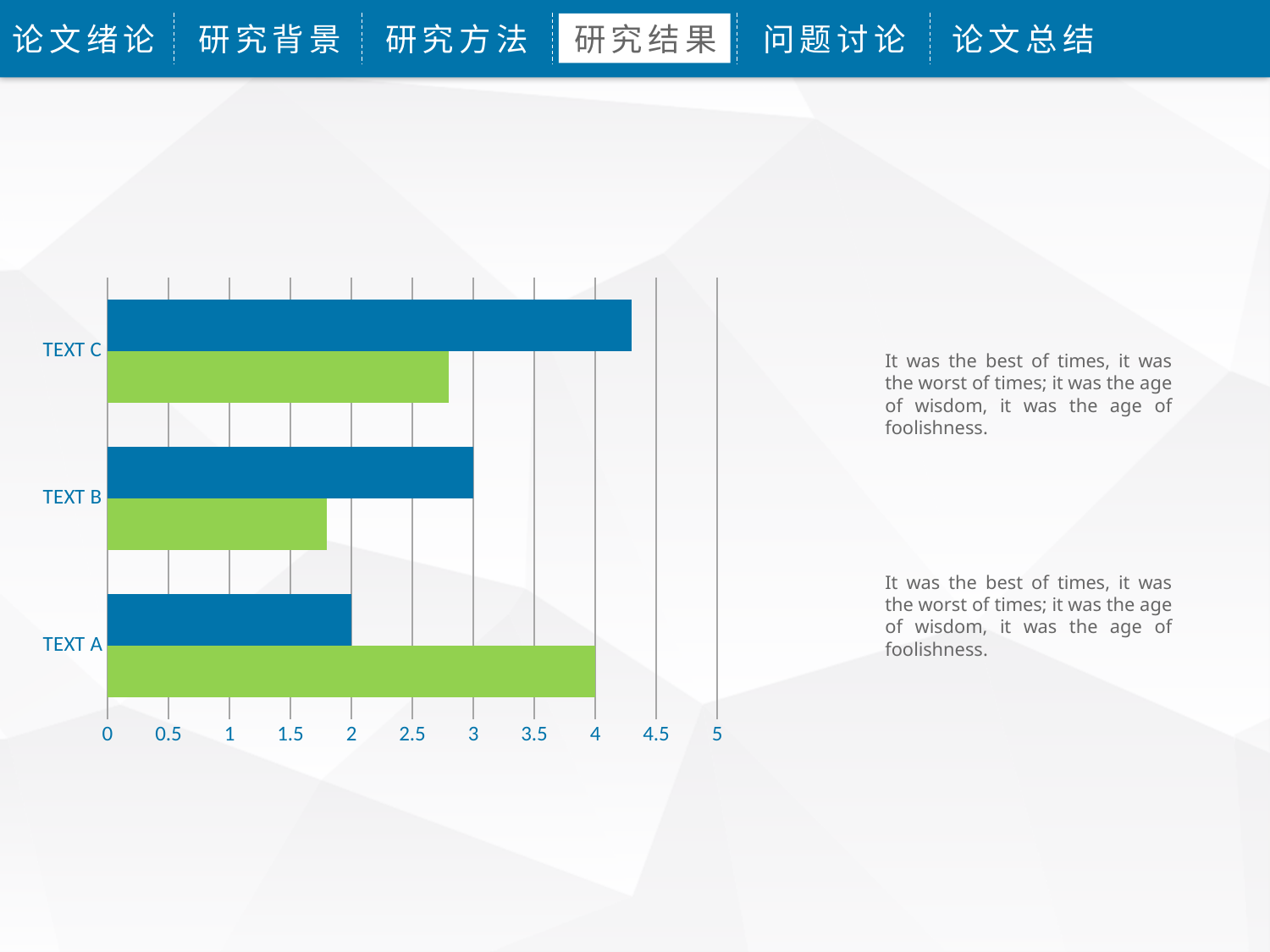
What is the value of the blue bar for TEXT A? 2 What is the value of the blue bar for TEXT B? 3 What is the value of the green bar for TEXT A? 4 Which category has the longest green bar? TEXT A What is the difference between the green bar and the blue bar for TEXT A? 2 Is the value of the blue bar for TEXT C greater or less than 4? greater What kind of chart is shown on the slide? bar chart Which category has the longest blue bar? TEXT C For TEXT A, which bar is larger, the blue one or the green one? the green one How many categories are shown on the vertical axis of the chart? 3 Is the value of the green bar for TEXT B greater or less than 2? less Is the value of the green bar for TEXT C greater or less than 3? less